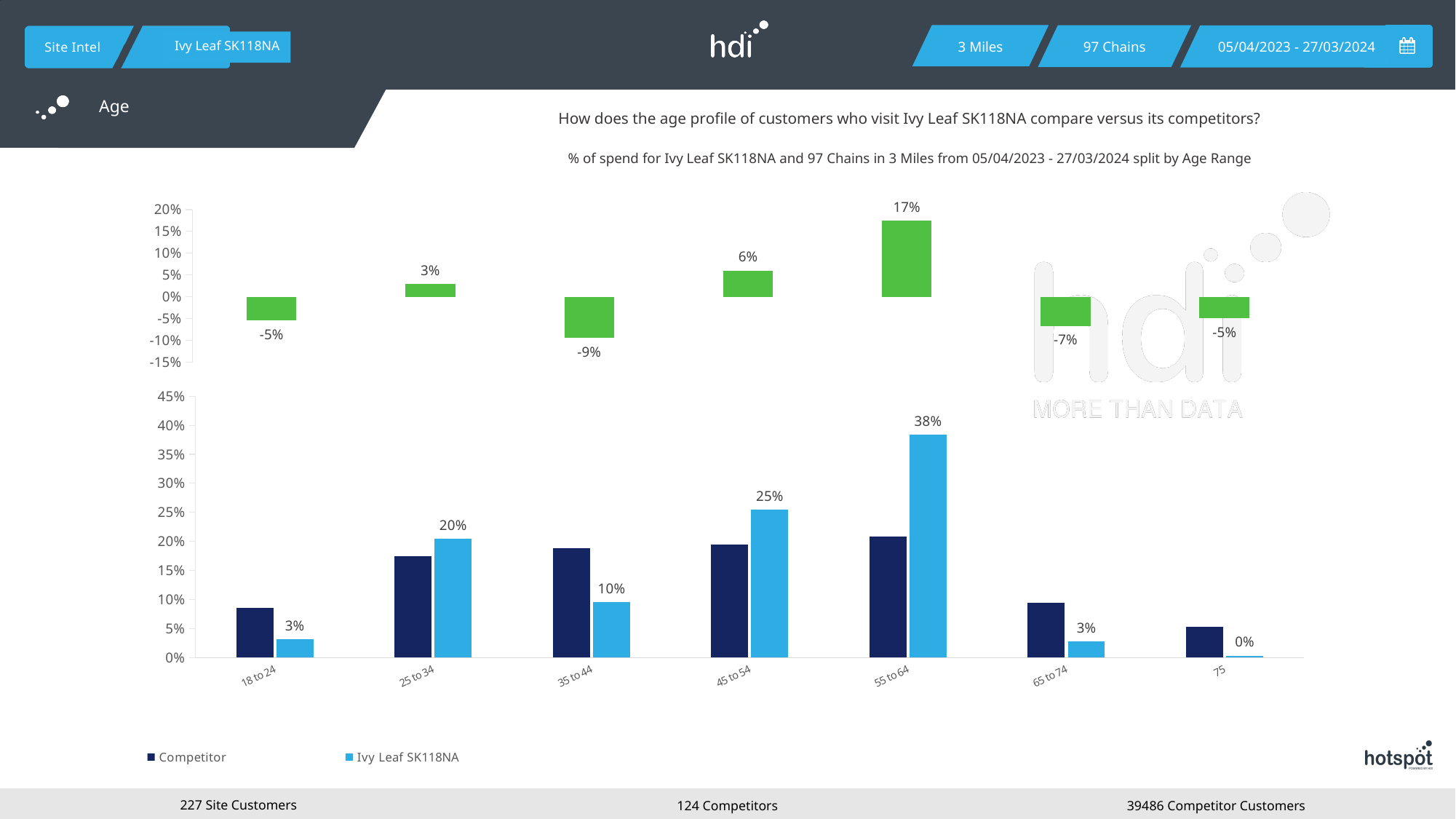
In the top chart, which age range has the lowest value? 35 to 44 In the bottom chart, for the 18 to 24 age range, which is larger: the Competitor bar or the Ivy Leaf SK118NA bar? Competitor How many series does the legend of the bottom chart list? 2 In the bottom chart, what is the value for Ivy Leaf SK118NA in the 55 to 64 age range? 38% How many age range categories are shown on the x axis of the bottom chart? 7 In the bottom chart, which age range has the highest value for Ivy Leaf SK118NA? 55 to 64 What type of chart is the bottom chart? Bar chart In the bottom chart, what is the difference between the Ivy Leaf SK118NA values for 55 to 64 and 45 to 54? 13% In the bottom chart, is the Competitor value for 55 to 64 greater or less than 15%? greater In the top chart, what is the value shown for the 35 to 44 age range? -9% In the bottom chart, what is the value for Ivy Leaf SK118NA in the 35 to 44 age range? 10% In the top chart, what is the value shown for the 55 to 64 age range? 17%